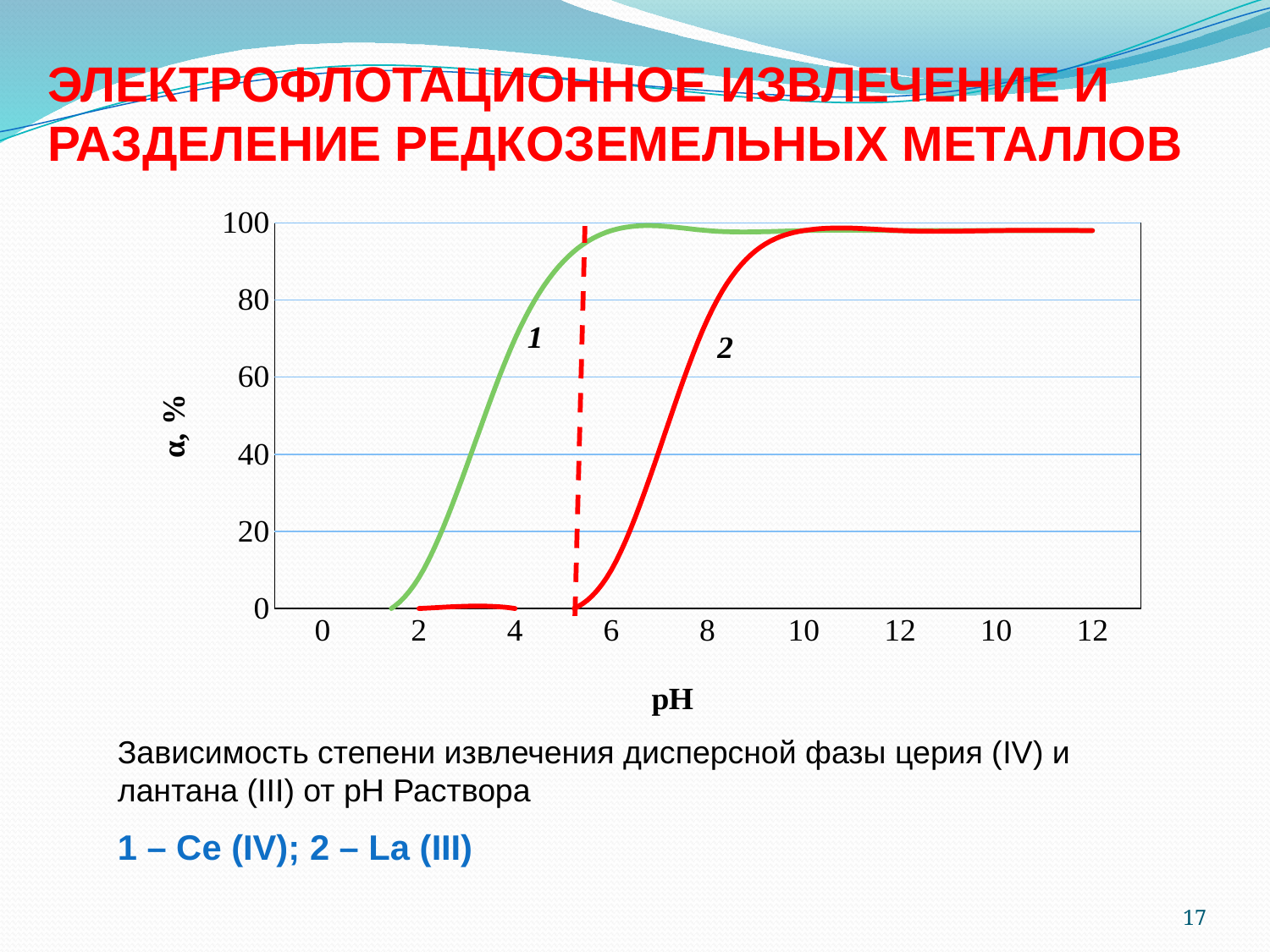
Is the value of curve 1 (Ce (IV)) at pH 4 greater or less than 60? greater What kind of chart is shown on the slide? line chart Is the value of curve 1 (Ce (IV)) at pH 2 greater or less than 20? less What is the label of the vertical axis of the chart? α, % Is the value of curve 2 (La (III)) at pH 6 greater or less than 20? less How many curves are plotted on the chart? 2 Does the value of curve 2 (La (III)) rise or fall as pH increases from 6 to 9? rise What is the label of the horizontal axis of the chart? pH At pH 4, which curve has the higher value, curve 1 (Ce (IV)) or curve 2 (La (III))? curve 1 (Ce (IV)) At pH 7, which curve has the higher value, curve 1 (Ce (IV)) or curve 2 (La (III))? curve 1 (Ce (IV))